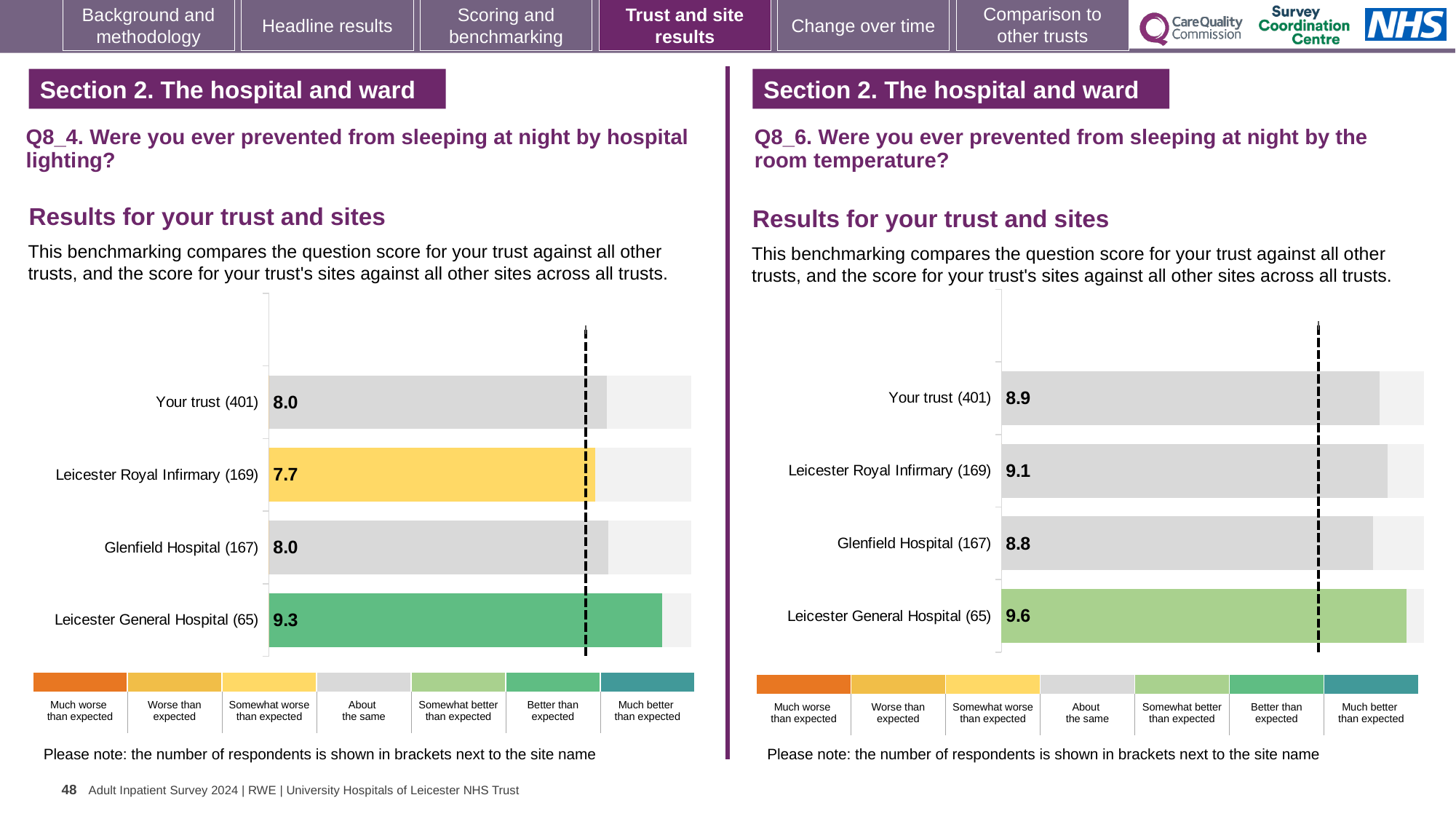
In the Q8_6 chart (room temperature), what is the score for Your trust? 8.9 In the Q8_4 chart (hospital lighting), which site or trust has the lowest score? Leicester Royal Infirmary In the Q8_6 chart (room temperature), what is the difference between the scores for Leicester General Hospital and Your trust? 0.7 In the Q8_4 chart (hospital lighting), what is the difference between the scores for Leicester General Hospital and Leicester Royal Infirmary? 1.6 In the Q8_4 chart (hospital lighting), what is the score for Leicester Royal Infirmary? 7.7 In the Q8_4 chart (hospital lighting), which benchmark category does the colour of the Leicester Royal Infirmary bar correspond to? Somewhat worse than expected In the Q8_4 chart (hospital lighting), how many bars are plotted? 4 In the Q8_6 chart (room temperature), which site or trust has the highest score? Leicester General Hospital In the Q8_6 chart (room temperature), what is the score for Glenfield Hospital? 8.8 In the Q8_4 chart (hospital lighting), what is the score for Leicester General Hospital? 9.3 What kind of chart is used on the left side of the slide for Q8_4? Bar chart In the Q8_6 chart (room temperature), which has the higher score, Leicester Royal Infirmary or Glenfield Hospital? Leicester Royal Infirmary